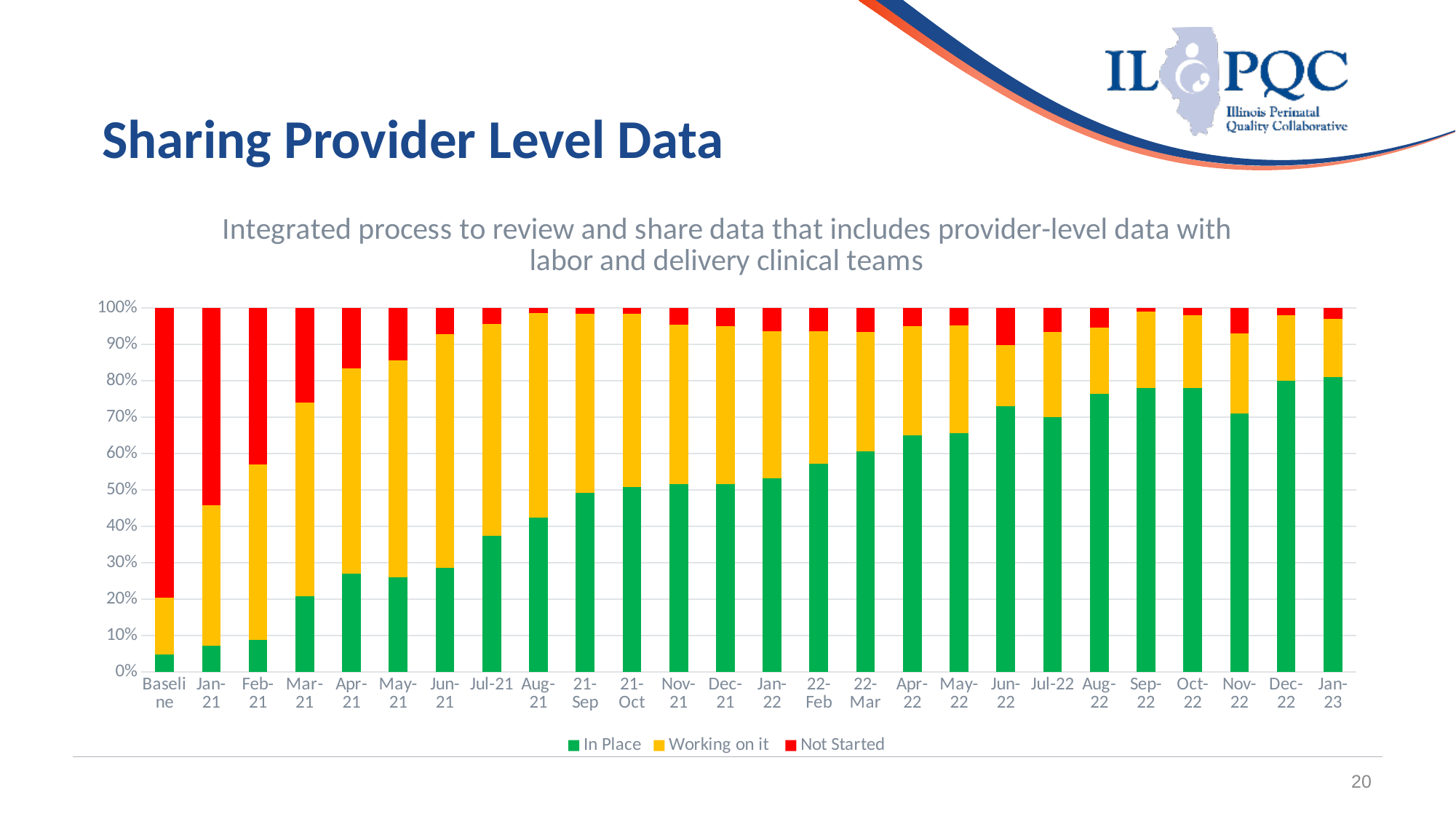
Is the In Place value for Aug-22 greater or less than 70%? greater Is the In Place value for Jan-23 greater or less than 70%? greater What is the title of the chart? Integrated process to review and share data that includes provider-level data with labor and delivery clinical teams Is the Not Started value for Baseline greater or less than 70%? greater Which has a larger In Place share, Baseline or Jan-23? Jan-23 Does the In Place share generally rise or fall from Baseline to Jan-23? rise How many series does the legend list? 3 Which category has the lowest In Place share? Baseline Which category has the highest Not Started share? Baseline How many time-period categories are plotted along the x axis? 26 What kind of chart is shown on the slide? Stacked bar chart